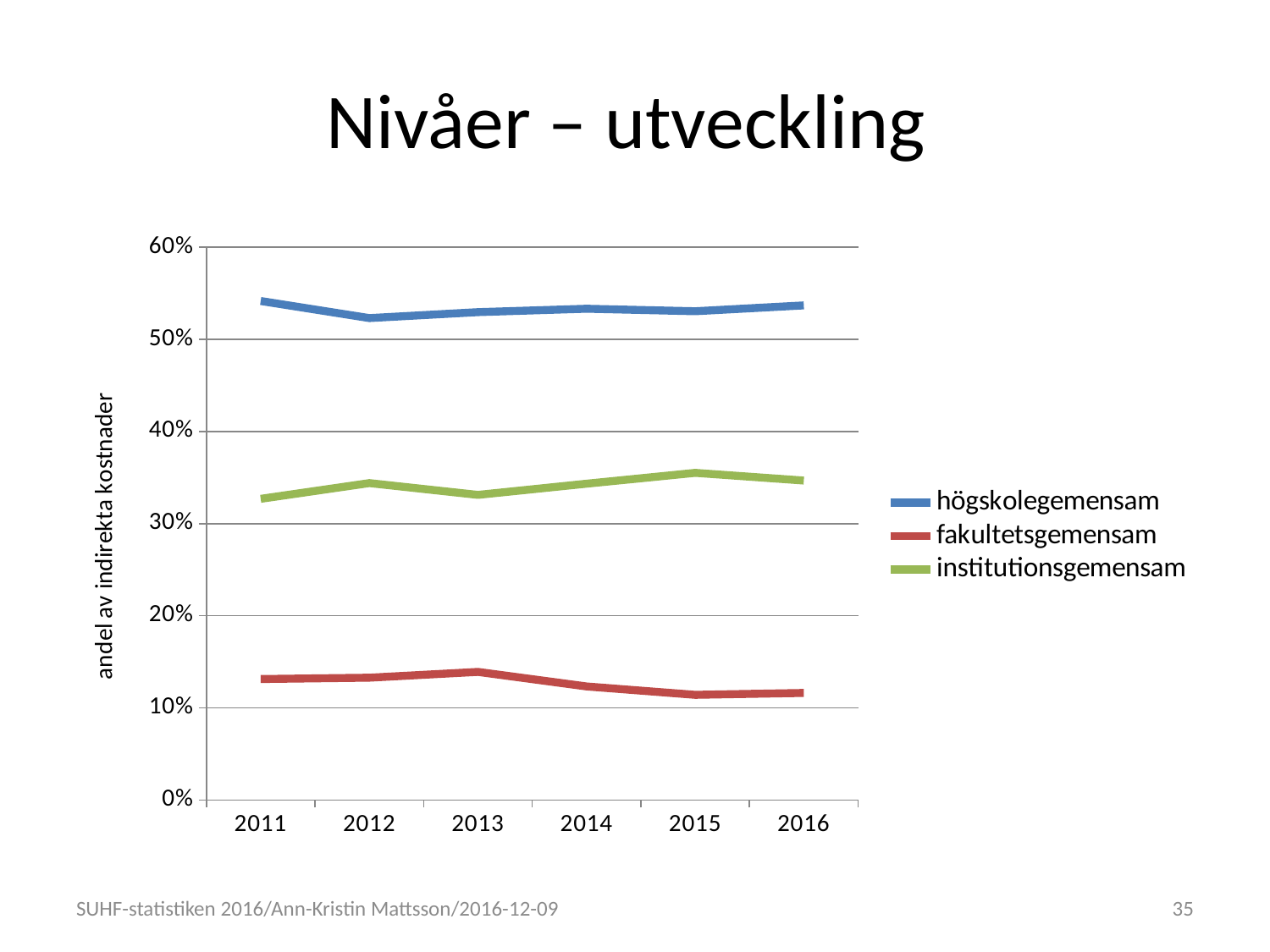
What is the title of the chart slide? Nivåer – utveckling How many series does the legend list? 3 Which series has the highest values across all years? högskolegemensam What kind of chart is shown on the slide? line chart Is the value for institutionsgemensam in 2015 greater or less than 30%? greater Is the value for institutionsgemensam in 2011 greater or less than 40%? less Which is larger in 2016: the value for institutionsgemensam or the value for fakultetsgemensam? institutionsgemensam Which series has the lowest values across all years? fakultetsgemensam Is the value for högskolegemensam in 2011 greater or less than 50%? greater How many years are shown on the x axis? 6 What is the label on the vertical axis? andel av indirekta kostnader